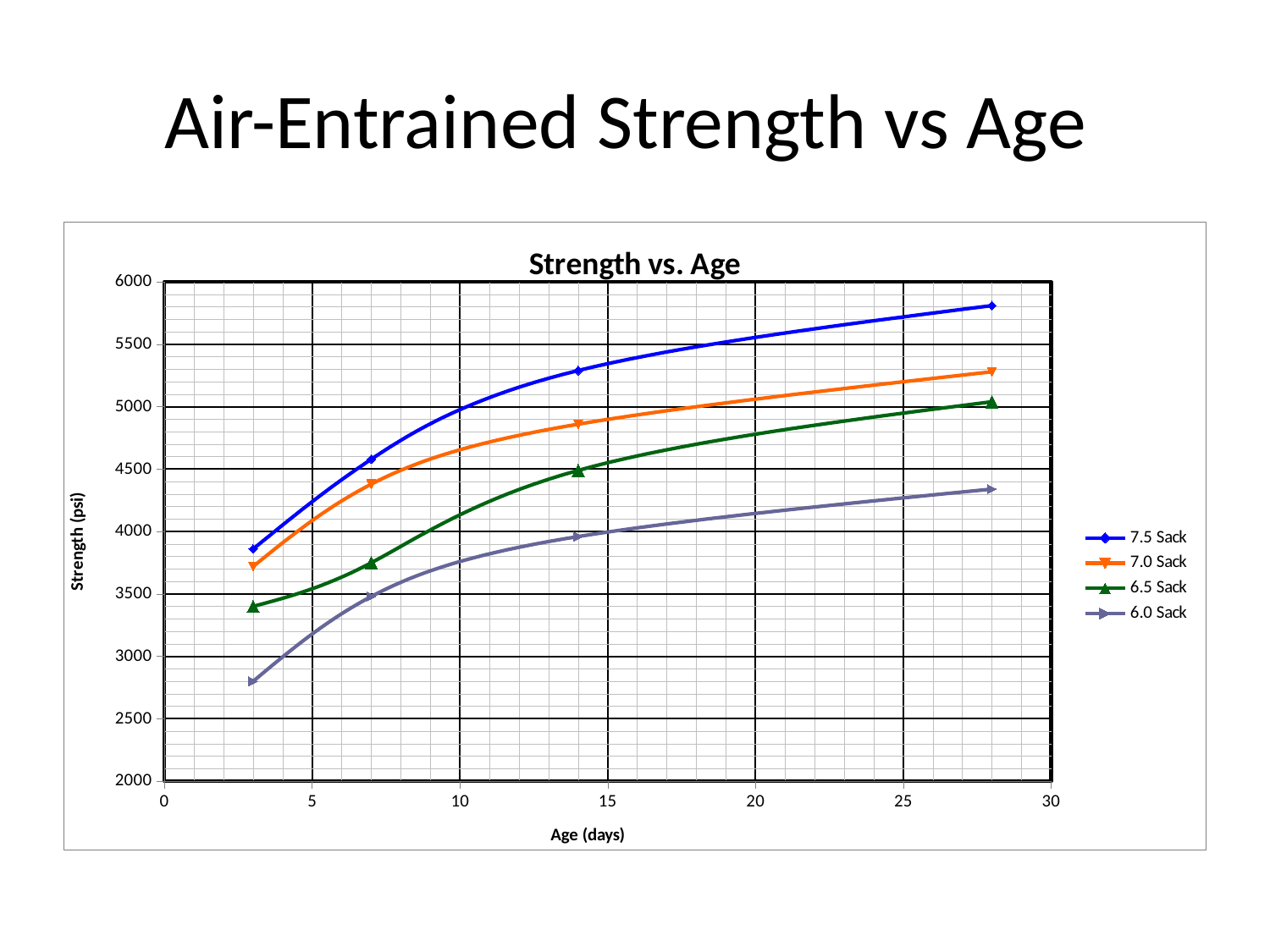
At 7 days, which is larger: the value for 7.0 Sack or the value for 6.5 Sack? 7.0 Sack Is the value for 7.0 Sack at 14 days greater or less than 5000? less Is the value for 6.0 Sack at 7 days greater or less than 4000? less Is the value for 6.0 Sack at 3 days greater or less than 3000? less Which series has the highest strength at 28 days? 7.5 Sack How many series does the legend list? 4 Which series has the lowest strength at 3 days? 6.0 Sack Does strength rise or fall as age increases for the 6.5 Sack series? rises How many data points are plotted for the 7.5 Sack series? 4 What is the label on the vertical axis of the chart? Strength (psi) What kind of chart is shown on the slide? line chart